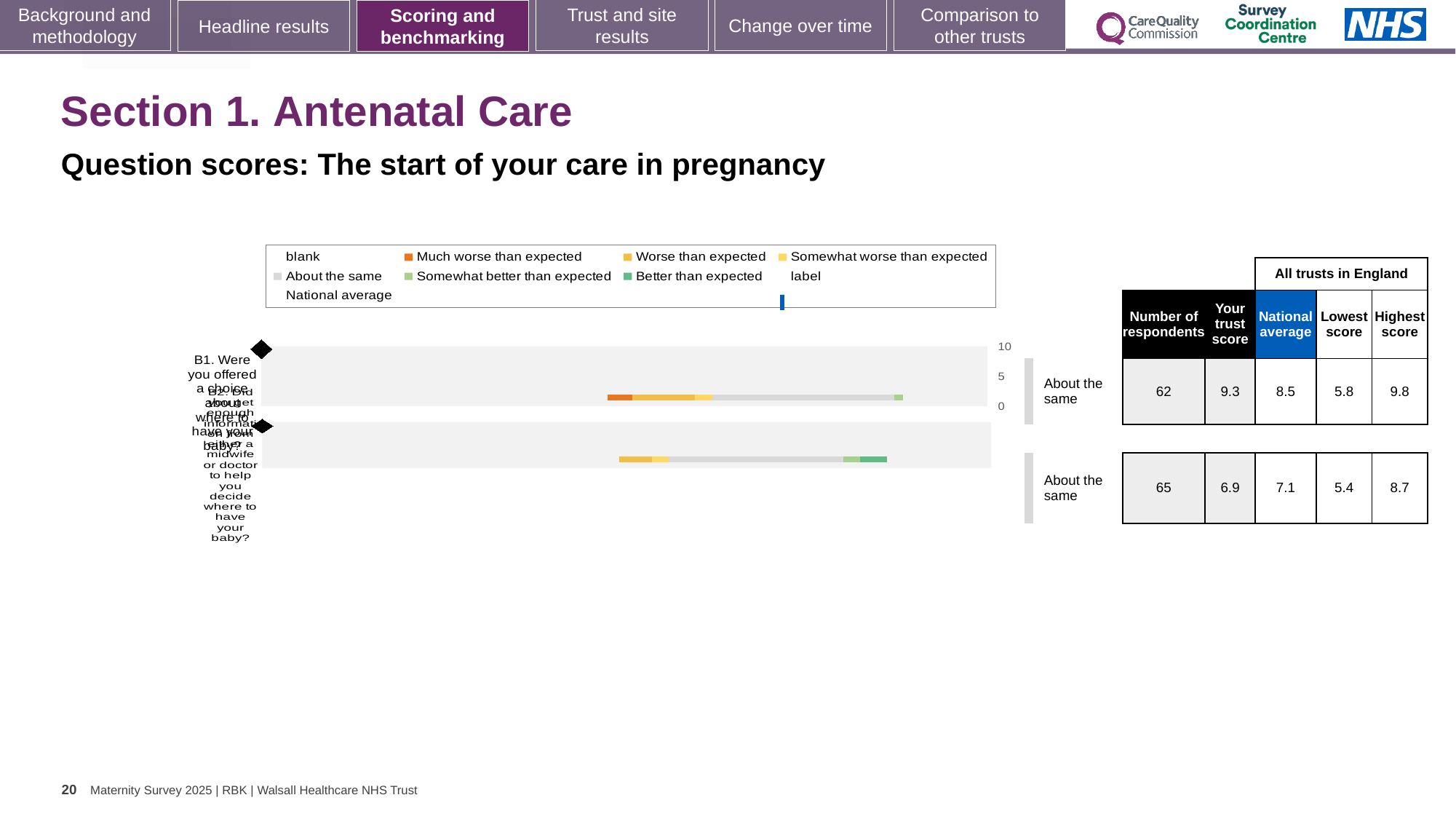
What is the trust score for question B1 (Were you offered a choice about where to have your baby?)? 9.3 What is the national average for question B2? 7.1 What type of chart is shown on the slide? bar chart How many questions (bars) are plotted in the chart? 2 For question B1, which is higher: the trust score or the national average? the trust score What is the difference between the national average and the trust score for question B2? 0.2 What is the lowest score across all trusts in England for question B2? 5.4 How many respondents answered question B1? 62 Which question has the higher trust score, B1 or B2? B1 What is the difference between the highest and lowest scores for question B1? 4.0 What benchmark category is shown for question B2? About the same What colour represents 'Much worse than expected' in the legend? orange